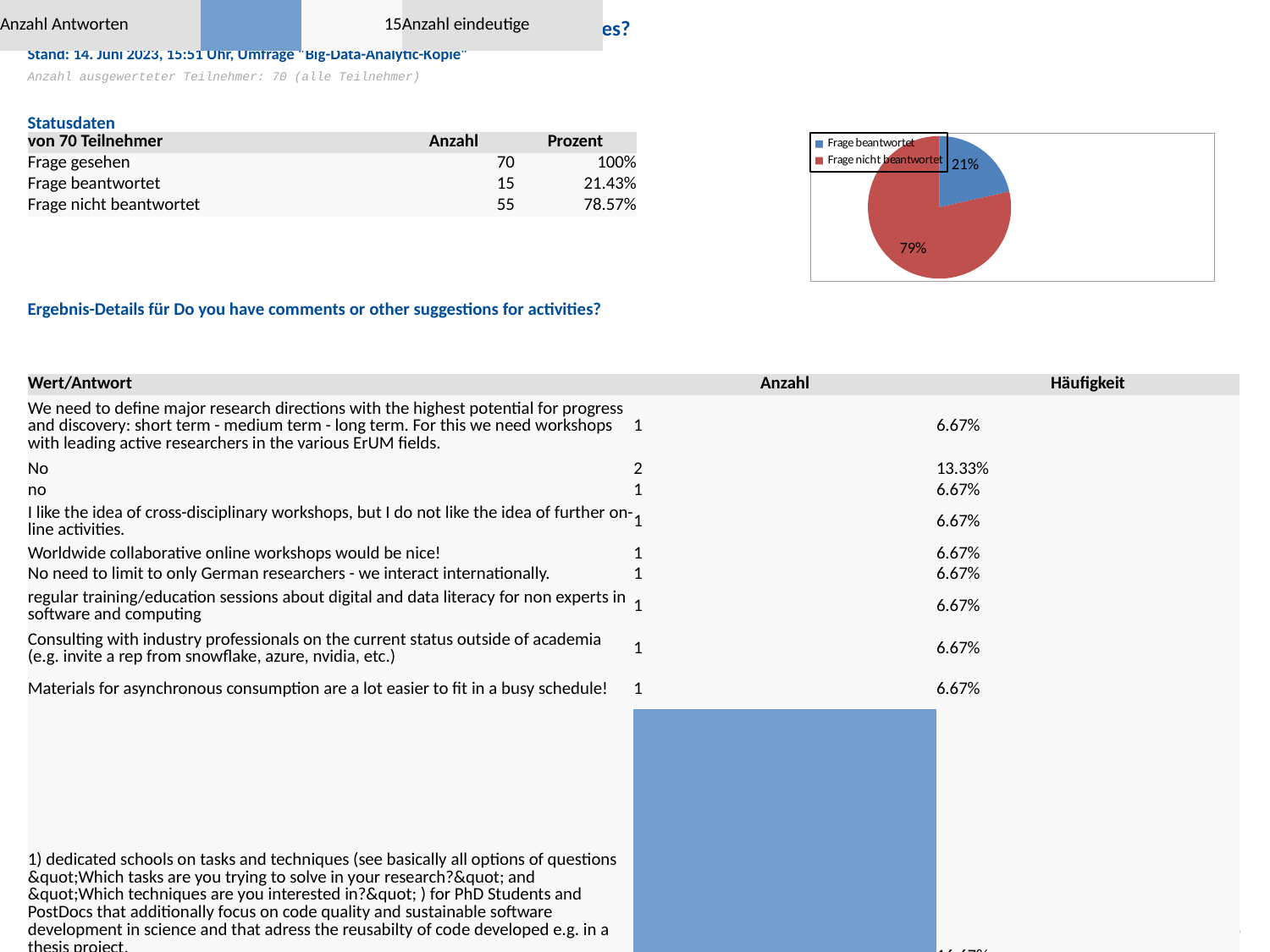
What colour is the "Frage beantwortet" slice in the pie chart? blue In the pie chart, what share is shown for "Frage nicht beantwortet"? 79% How many entries does the pie chart's legend list? 2 How many slices does the pie chart have? 2 In the pie chart, what share is shown for "Frage beantwortet"? 21% What is the difference in percentage points between the "Frage nicht beantwortet" and "Frage beantwortet" slices of the pie chart? 58% What colour is the "Frage nicht beantwortet" slice in the pie chart? red Which slice of the pie chart is the smallest? Frage beantwortet Which slice of the pie chart is the largest? Frage nicht beantwortet In the pie chart, which is larger: "Frage beantwortet" or "Frage nicht beantwortet"? Frage nicht beantwortet What kind of chart is shown on the slide? pie chart